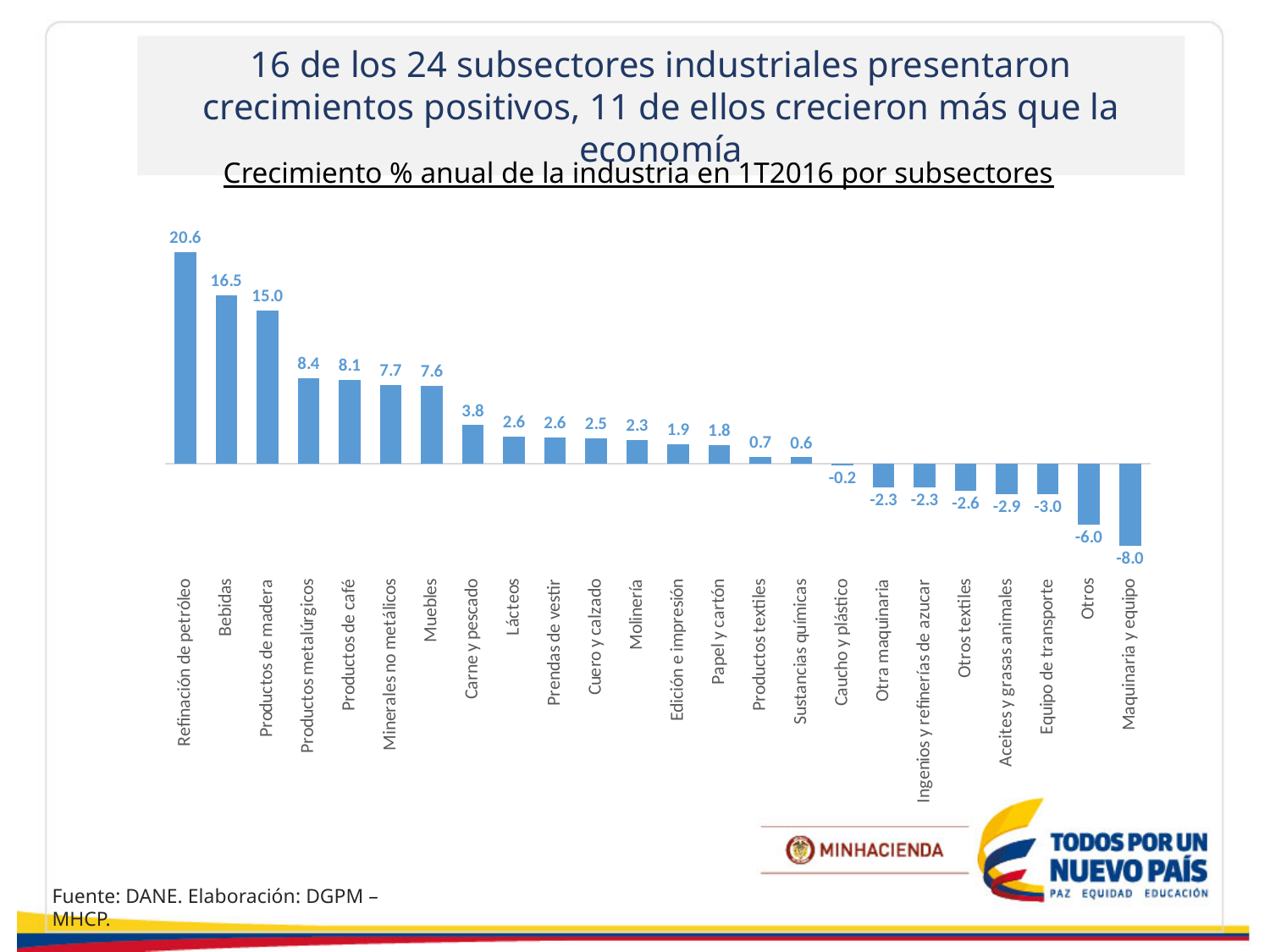
What is the value for Refinación de petróleo? 20.6 What kind of chart is this? Bar chart What is the difference between the values for Bebidas and Productos de madera? 1.5 What is the value for Carne y pescado? 3.8 How many subsectors are shown in the chart? 24 What is the value for Equipo de transporte? -3.0 Which is larger, the value for Productos metalúrgicos or the value for Muebles? Productos metalúrgicos What is the difference between the values for Refinación de petróleo and Maquinaria y equipo? 28.6 What is the value for Sustancias químicas? 0.6 Which subsector has the highest value? Refinación de petróleo Do the values rise or fall from left to right along the x axis? Fall Which subsector has the lowest value? Maquinaria y equipo